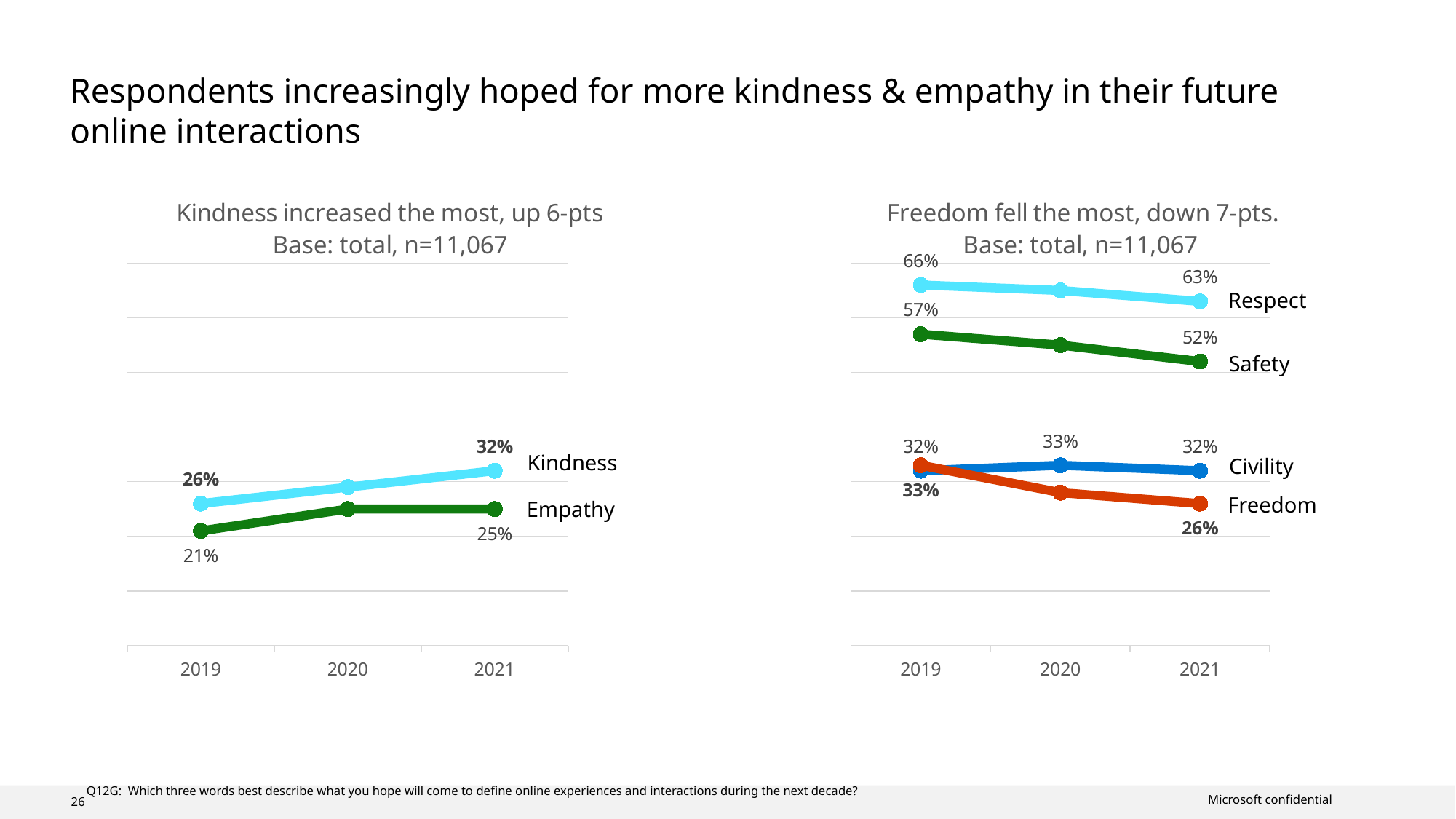
In the right chart titled 'Freedom fell the most, down 7-pts.', what was the value for Safety in 2021? 52% In the left chart titled 'Kindness increased the most, up 6-pts', what was the value for Kindness in 2021? 32% What type of chart is the left chart titled 'Kindness increased the most, up 6-pts'? line chart In the right chart titled 'Freedom fell the most, down 7-pts.', which series had the highest value in 2021? Respect In the left chart titled 'Kindness increased the most, up 6-pts', what was the value for Empathy in 2019? 21% In the left chart titled 'Kindness increased the most, up 6-pts', by how many percentage points did Kindness rise from 2019 to 2021? 6 percentage points In the left chart titled 'Kindness increased the most, up 6-pts', does the Empathy line rise or fall from 2019 to 2021? rise In the right chart titled 'Freedom fell the most, down 7-pts.', what is the difference between Respect and Safety in 2019? 9 percentage points In the right chart titled 'Freedom fell the most, down 7-pts.', which series had the lowest value in 2021? Freedom How many series are plotted in the right chart titled 'Freedom fell the most, down 7-pts.'? 4 In the right chart titled 'Freedom fell the most, down 7-pts.', which was larger in 2021, Civility or Freedom? Civility In the right chart titled 'Freedom fell the most, down 7-pts.', what was the value for Freedom in 2019? 33%